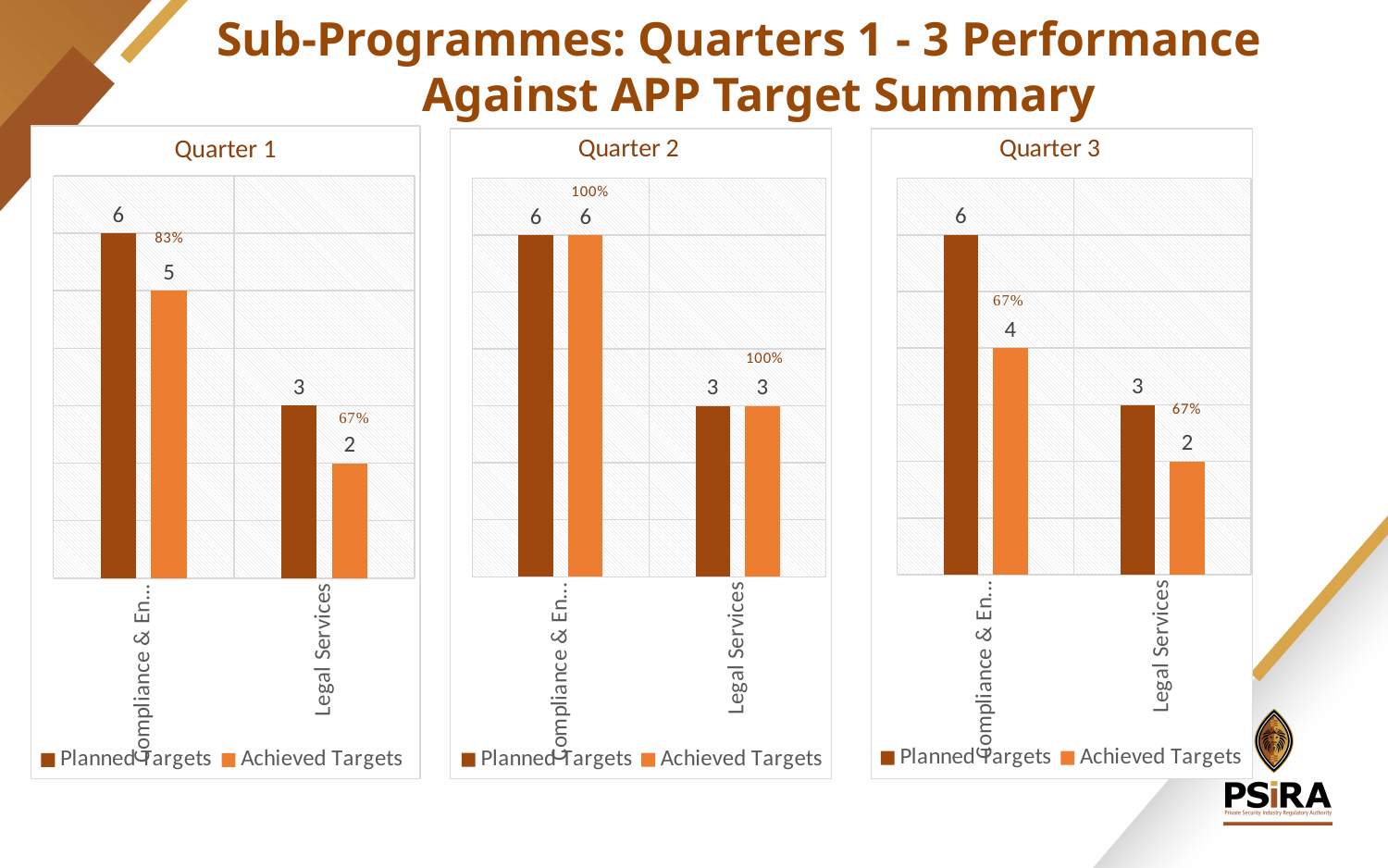
In the Quarter 3 chart, what is the difference between the Planned Targets and Achieved Targets values for Legal Services? 1 How many categories are shown on the x axis of the Quarter 2 chart? 2 In the Quarter 1 chart, what percentage label is shown above the Achieved Targets bar for Legal Services? 67% How many series does the legend of the Quarter 3 chart list? 2 In the Quarter 2 chart, what percentage label is shown above the Achieved Targets bar for Legal Services? 100% In the Quarter 1 chart, what is the Achieved Targets value for Legal Services? 2 In the Quarter 3 chart, what is the Achieved Targets value for Legal Services? 2 In the Quarter 3 chart, what is the difference between the Planned Targets value for the first category and the Planned Targets value for Legal Services? 3 In the Quarter 1 chart, which is larger for Legal Services: Planned Targets or Achieved Targets? Planned Targets What are the two legend entries in the Quarter 2 chart? Planned Targets and Achieved Targets What type of chart is the Quarter 1 chart? Bar chart In the Quarter 2 chart, what is the Planned Targets value for Legal Services? 3